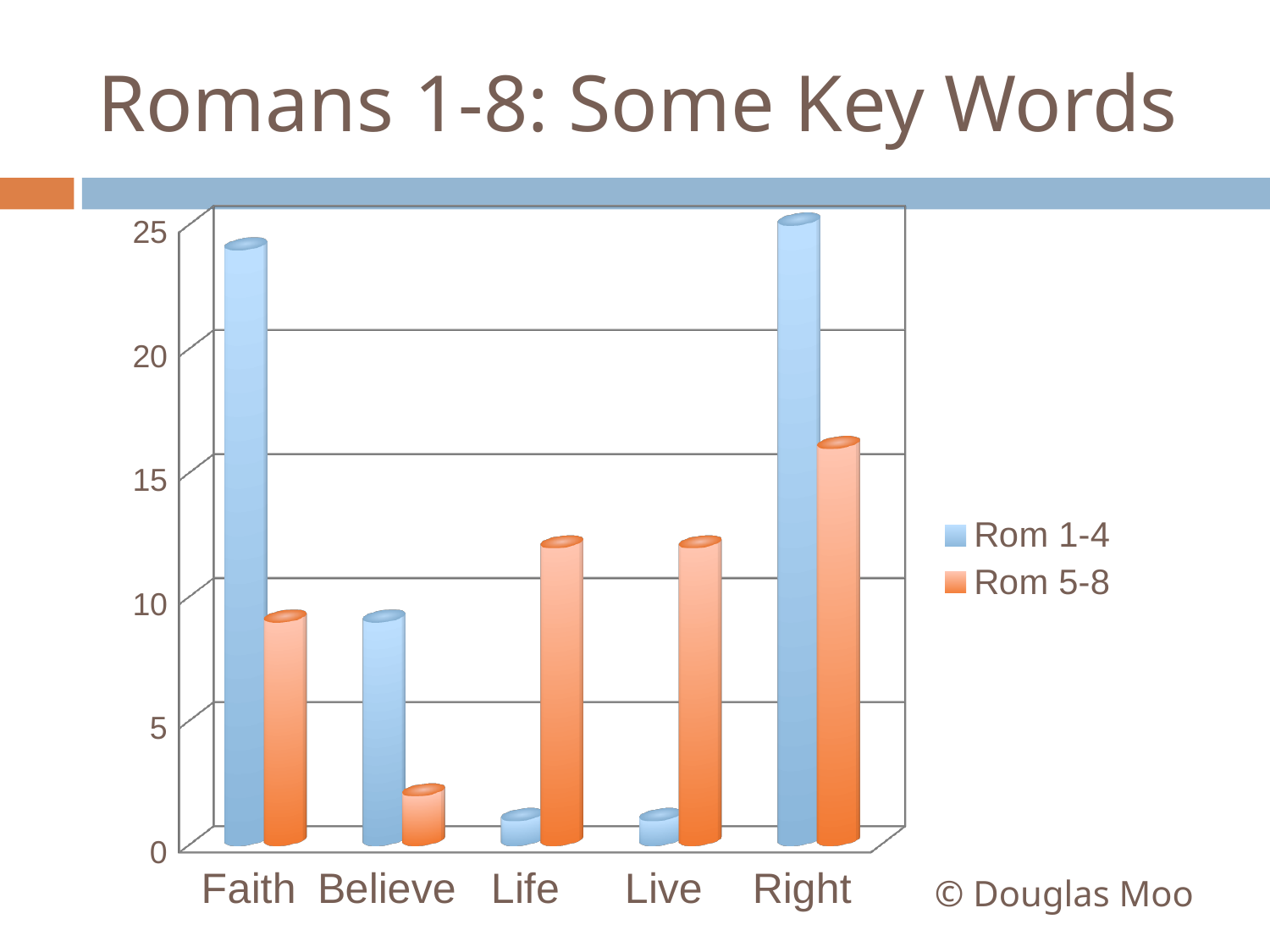
Which category has the lowest Rom 5-8 value? Believe Is the Rom 1-4 value for Faith greater or less than 20? greater Is the Rom 5-8 value for Life greater or less than 10? greater What kind of chart is shown on the slide? Bar chart For Life, which series has the larger value, Rom 1-4 or Rom 5-8? Rom 5-8 Which series are listed in the chart's legend? Rom 1-4 and Rom 5-8 Is the Rom 1-4 value for Right greater or less than 20? greater How many series does the chart's legend list? 2 Which category has the highest Rom 5-8 value? Right What colour are the Rom 5-8 bars in the chart? Orange How many categories are shown on the x axis of the chart? 5